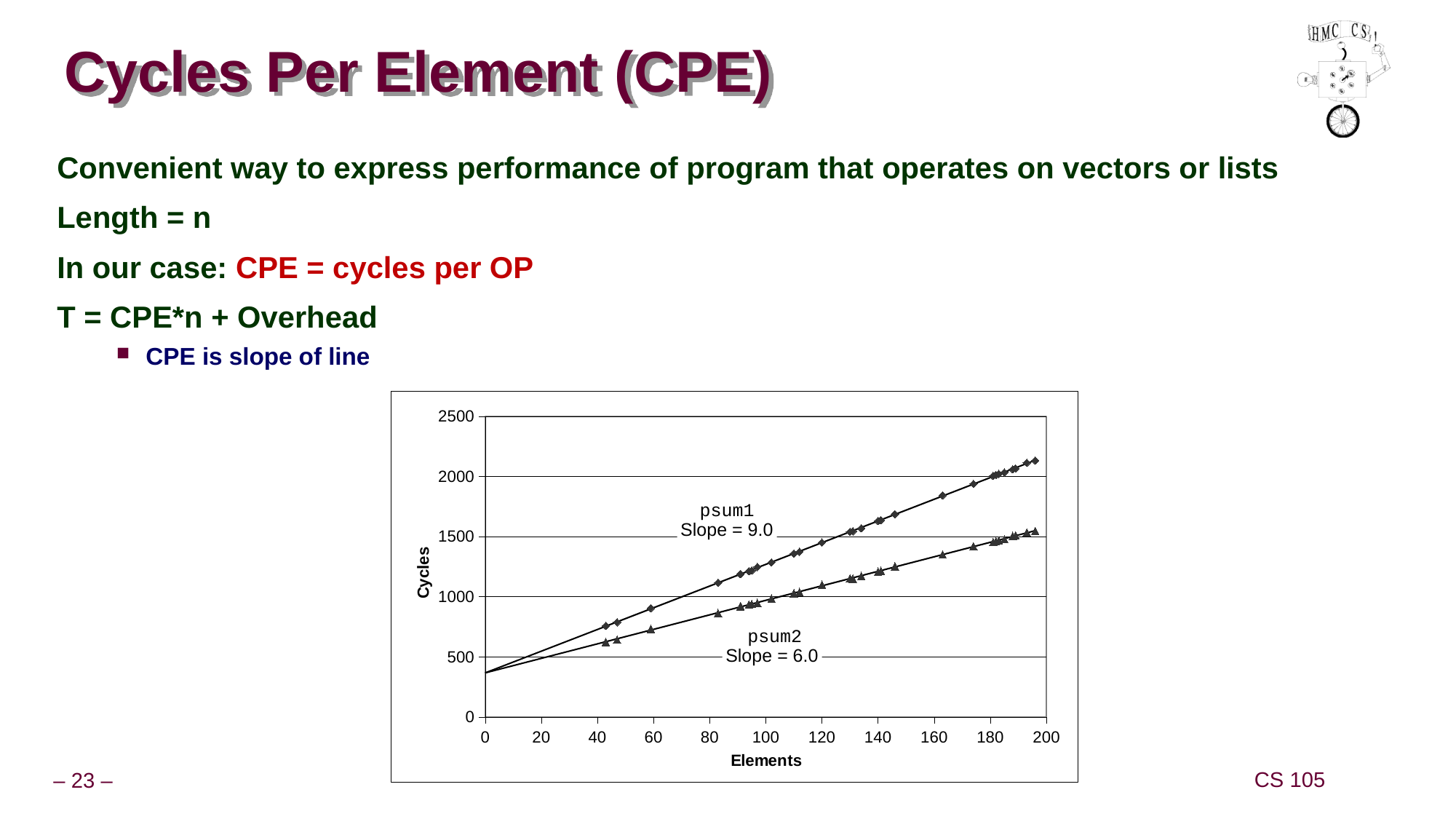
How many data series are plotted on the chart? 2 Is the value for psum2 at about 195 elements greater or less than 2000 cycles? less What is the label of the x axis? Elements What is the label of the y axis? Cycles Is the value for psum2 at about 60 elements greater or less than 1000 cycles? less Which series has the larger slope, psum1 or psum2? psum1 Which series has more cycles at 160 elements, psum1 or psum2? psum1 Is the value for psum1 at about 195 elements greater or less than 2000 cycles? greater What is the slope labelled for the psum2 series? 6.0 What kind of chart is shown on the slide? scatter (line) chart What is the slope labelled for the psum1 series? 9.0 Do the cycles for psum1 rise or fall as the number of elements increases? rise